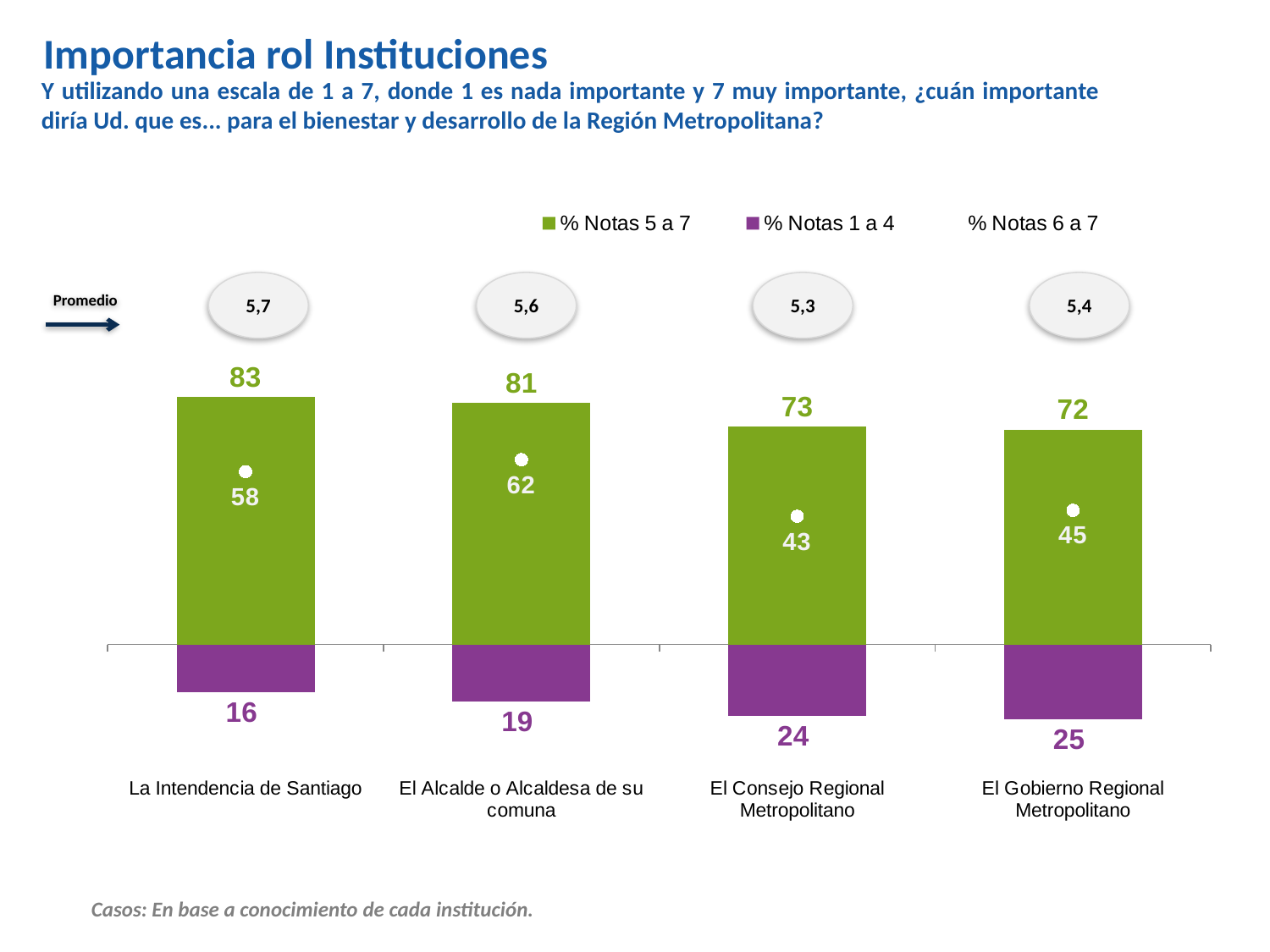
What is the difference between the % Notas 5 a 7 values for La Intendencia de Santiago and El Gobierno Regional Metropolitano? 11 How many series does the legend list? 3 What is the Promedio shown for El Gobierno Regional Metropolitano? 5,4 Which colour represents the % Notas 1 a 4 series? purple What is the % Notas 1 a 4 value for El Consejo Regional Metropolitano? 24 What is the % Notas 6 a 7 value for El Alcalde o Alcaldesa de su comuna? 62 Which category has the highest % Notas 5 a 7 value? La Intendencia de Santiago Which category has the lowest % Notas 6 a 7 value? El Consejo Regional Metropolitano How many categories are shown on the x axis? 4 Which is larger: the % Notas 1 a 4 value for El Alcalde o Alcaldesa de su comuna or for El Gobierno Regional Metropolitano? El Gobierno Regional Metropolitano What is the % Notas 5 a 7 value for La Intendencia de Santiago? 83 What kind of chart is shown on the slide? bar chart